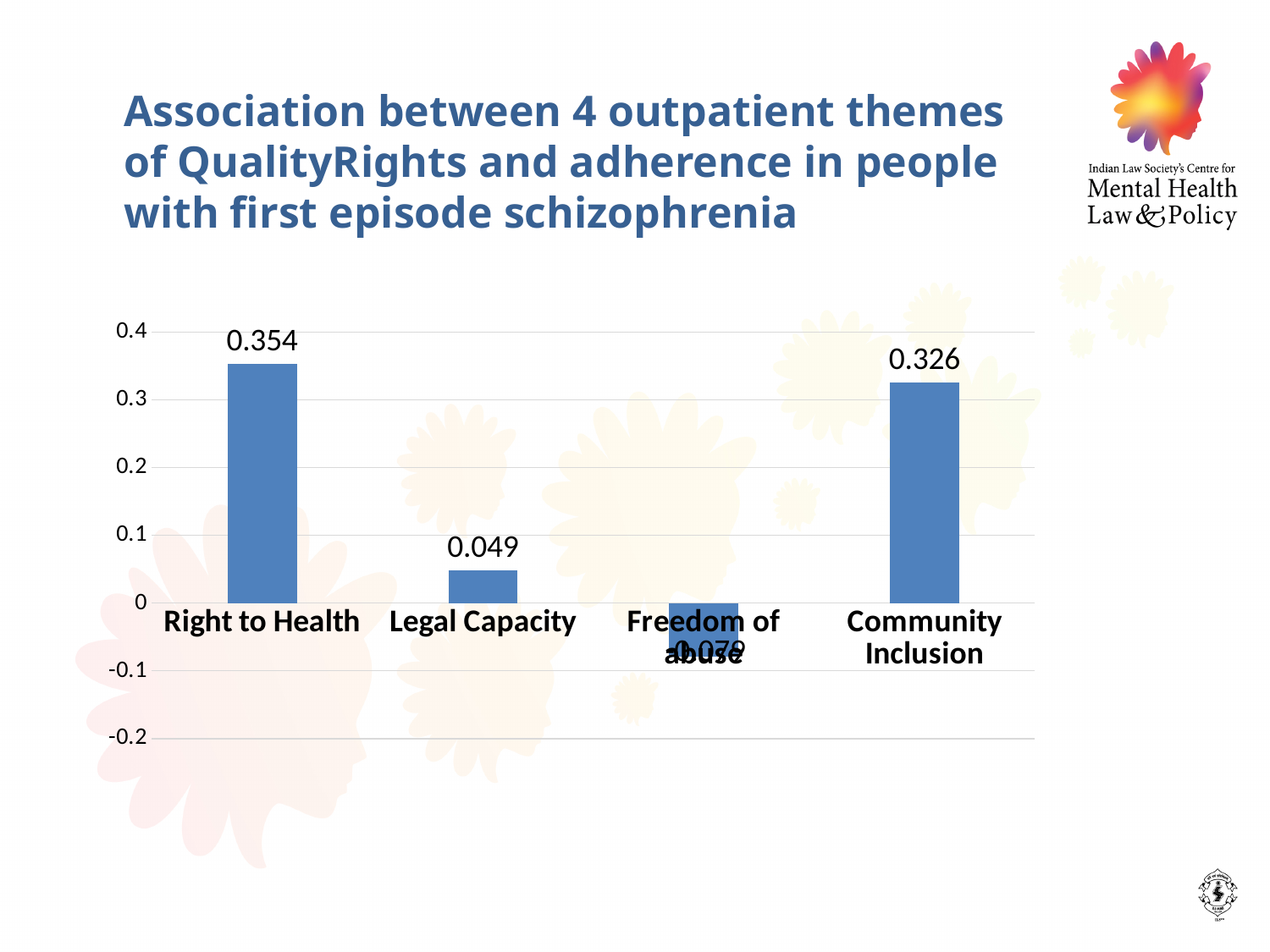
What kind of chart is shown on the slide? bar chart Which category has the highest value? Right to Health Is the value for Freedom of abuse greater or less than 0? less Which category has the lowest value? Freedom of abuse What is the difference between the values for Community Inclusion and Legal Capacity? 0.277 What is the lowest value shown on the vertical axis? -0.2 What is the value for Community Inclusion? 0.326 What is the value for Right to Health? 0.354 What is the value for Legal Capacity? 0.049 Which is larger, the value for Legal Capacity or the value for Community Inclusion? Community Inclusion What is the difference between the values for Right to Health and Community Inclusion? 0.028 How many categories are shown in the chart? 4